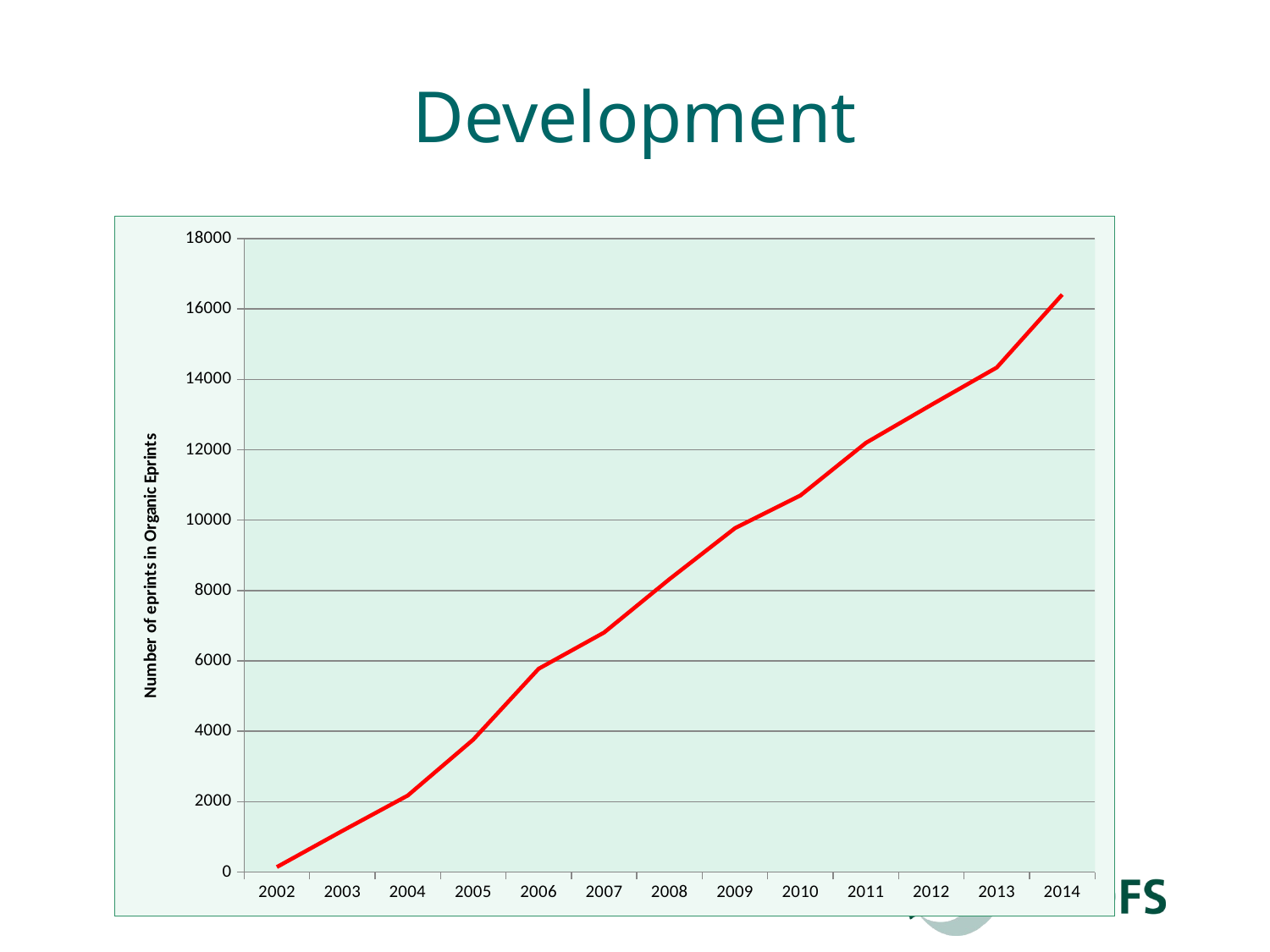
Is the value for 2012 greater or less than 14000? less Which year has a larger number of eprints, 2005 or 2011? 2011 What kind of chart is shown on the slide? line chart Is the value for 2002 greater or less than 2000? less Is the value for 2010 greater or less than 10000? greater Which year has the lowest number of eprints in Organic Eprints? 2002 What is the label on the y axis of the chart? Number of eprints in Organic Eprints How many years are plotted along the x axis of the chart? 13 Do the values in the chart rise or fall from 2002 to 2014? rise Which year has the highest number of eprints in Organic Eprints? 2014